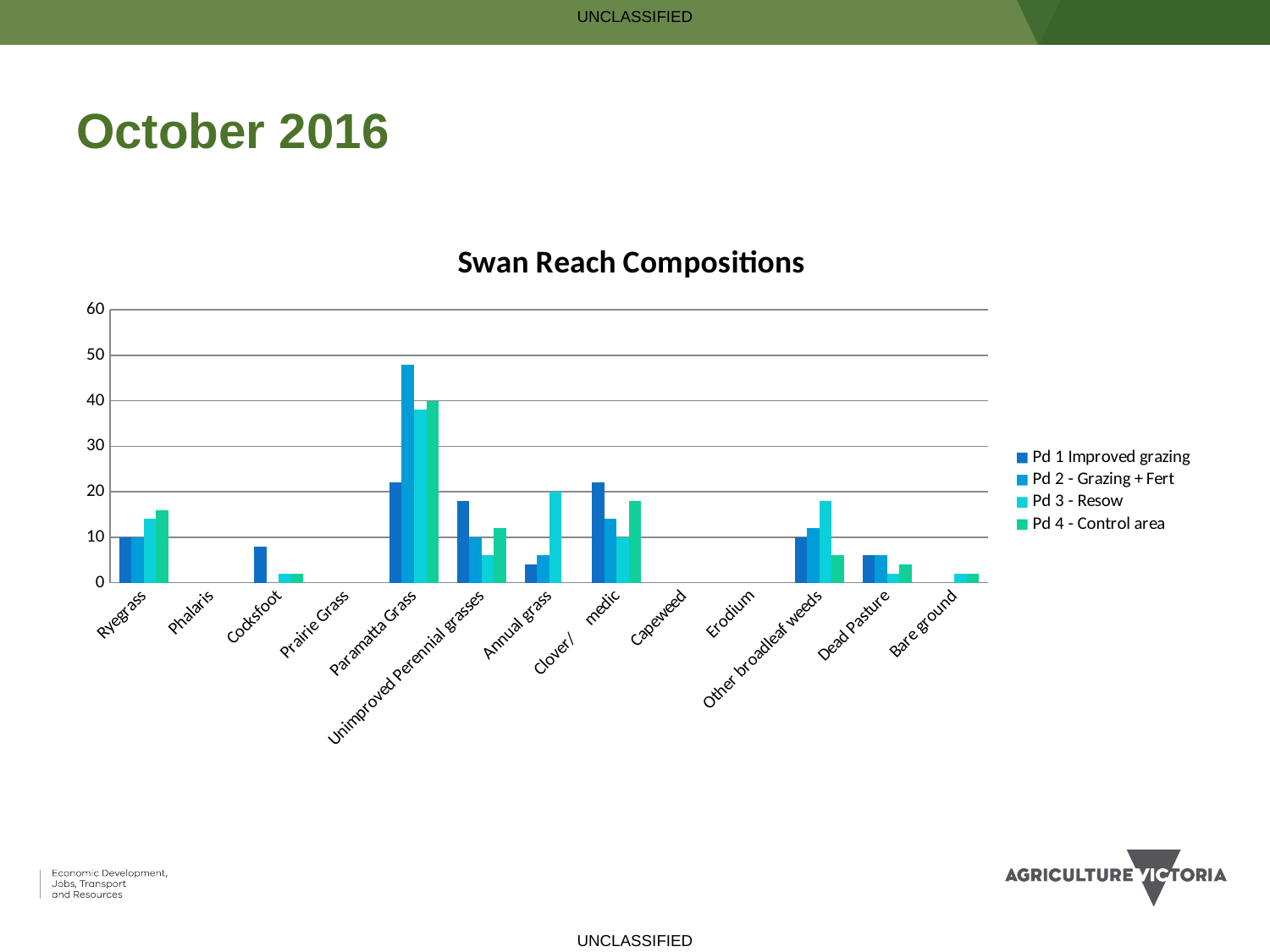
Is the value for Pd 1 Improved grazing at Clover/ medic greater or less than 20? greater Which category has the tallest bar in the chart? Paramatta Grass What is the title of the chart? Swan Reach Compositions What kind of chart is shown on the slide? bar chart Which is larger for Unimproved Perennial grasses: Pd 1 Improved grazing or Pd 3 - Resow? Pd 1 Improved grazing Is the value for Pd 1 Improved grazing at Cocksfoot greater or less than 10? less Is the value for Pd 2 - Grazing + Fert at Paramatta Grass greater or less than 40? greater Which series is shown in the darkest blue colour in the legend? Pd 1 Improved grazing Which series has the highest value for Paramatta Grass? Pd 2 - Grazing + Fert How many categories are shown along the x axis? 13 How many series does the legend list? 4 Which is larger for Annual grass: Pd 3 - Resow or Pd 1 Improved grazing? Pd 3 - Resow